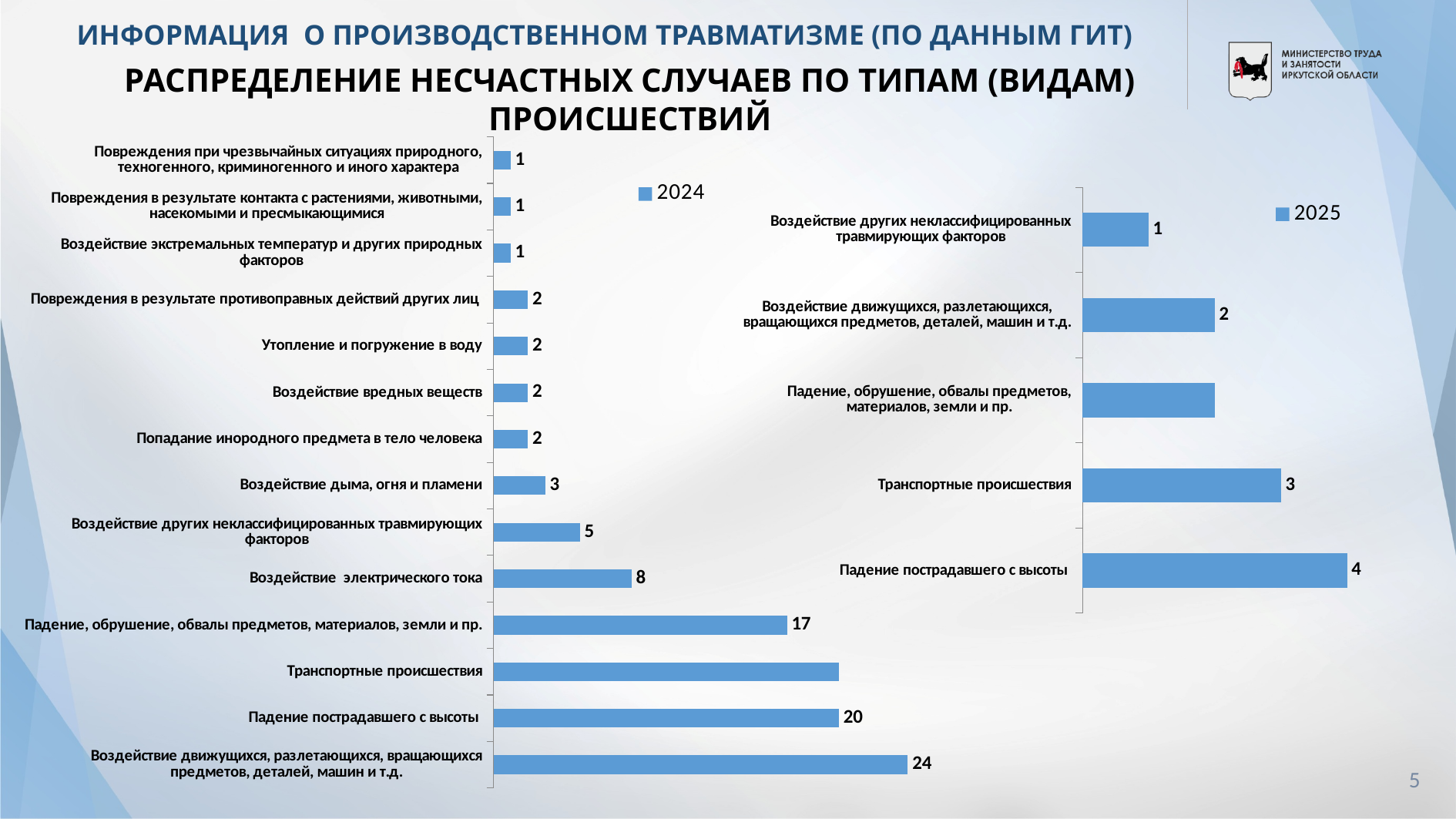
How many categories are shown in the 2025 chart on the right? 5 In the 2024 chart on the left, what is the value for Воздействие электрического тока? 8 In the 2024 chart on the left, which is larger: Воздействие дыма, огня и пламени or Воздействие других неклассифицированных травмирующих факторов? Воздействие других неклассифицированных травмирующих факторов In the 2024 chart on the left, what is the difference between the values for Воздействие движущихся, разлетающихся, вращающихся предметов, деталей, машин и т.д. and Падение пострадавшего с высоты? 4 What legend entry is shown for the chart on the left? 2024 In the 2025 chart on the right, what is the difference between the values for Падение пострадавшего с высоты and Воздействие других неклассифицированных травмирующих факторов? 3 In the 2024 chart on the left, which category has the highest value? Воздействие движущихся, разлетающихся, вращающихся предметов, деталей, машин и т.д. In the 2024 chart on the left, what is the value for Падение, обрушение, обвалы предметов, материалов, земли и пр.? 17 In the 2025 chart on the right, what is the value for Транспортные происшествия? 3 What type of chart is the 2025 chart on the right? Bar chart How many categories are shown in the 2024 chart on the left? 14 In the 2025 chart on the right, which category has the highest value? Падение пострадавшего с высоты